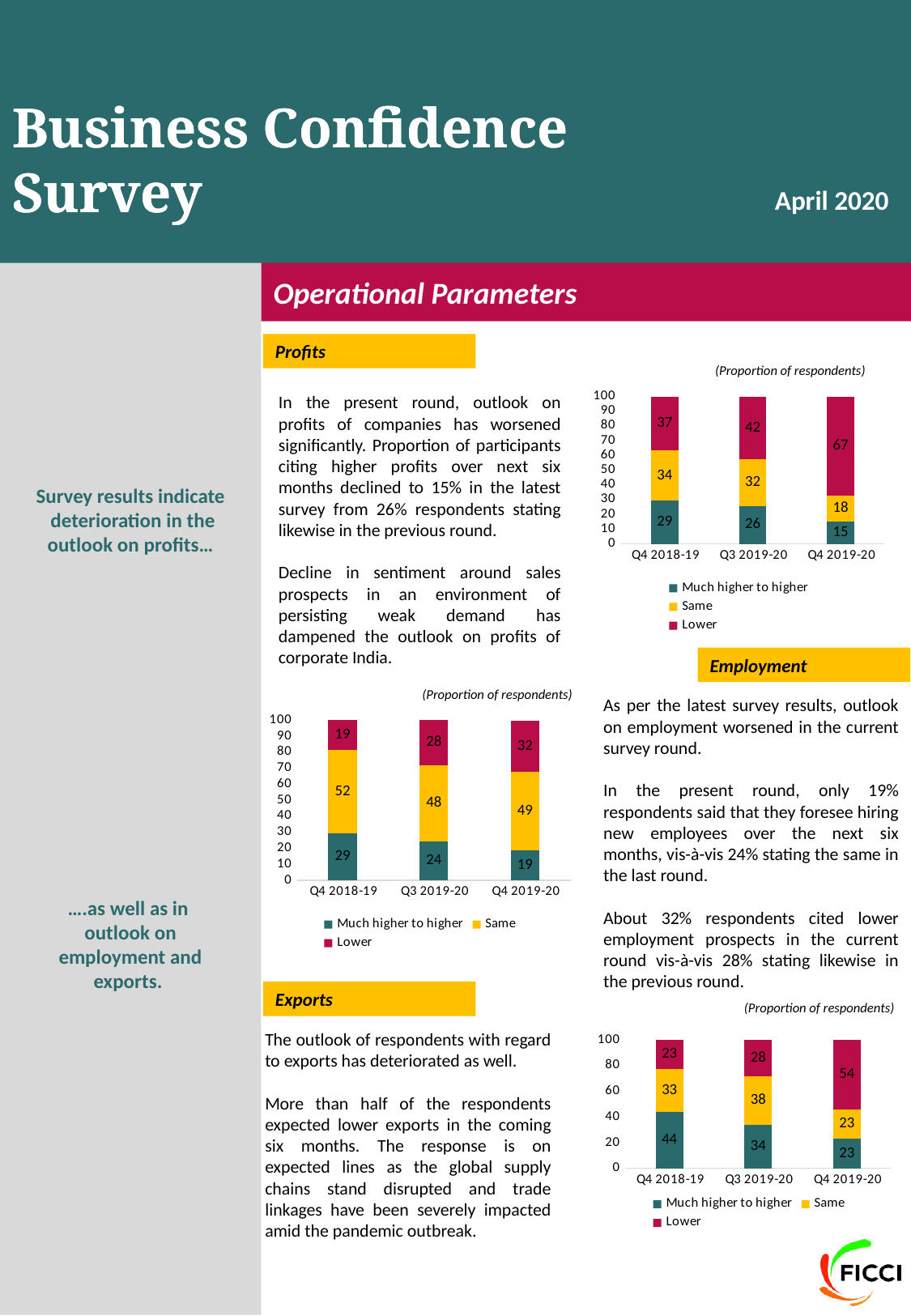
In the chart in the middle left of the slide, which period has the lowest 'Much higher to higher' value? Q4 2019-20 In the chart in the middle left of the slide, what is the value for 'Same' in Q3 2019-20? 48 In the chart in the middle left of the slide, how does the 'Much higher to higher' value change from Q4 2018-19 to Q4 2019-20? It falls In the chart at the bottom right of the slide, which is larger: 'Much higher to higher' in Q4 2018-19 or 'Much higher to higher' in Q3 2019-20? Q4 2018-19 What kind of chart is shown at the bottom right of the slide? Stacked bar chart In the chart at the top right of the slide, what is the difference between the 'Same' values for Q4 2018-19 and Q4 2019-20? 16 In the chart at the top right of the slide, which period has the highest 'Lower' value? Q4 2019-20 In the chart at the top right of the slide, what is the value for 'Lower' in Q4 2019-20? 67 In the chart at the bottom right of the slide, what is the value for 'Lower' in Q4 2019-20? 54 In the chart at the bottom right of the slide, what is the total of the stacked bar for Q3 2019-20? 100 In the chart at the top right of the slide, what is the value for 'Much higher to higher' in Q3 2019-20? 26 In the chart in the middle left of the slide, how many series does the legend list? 3